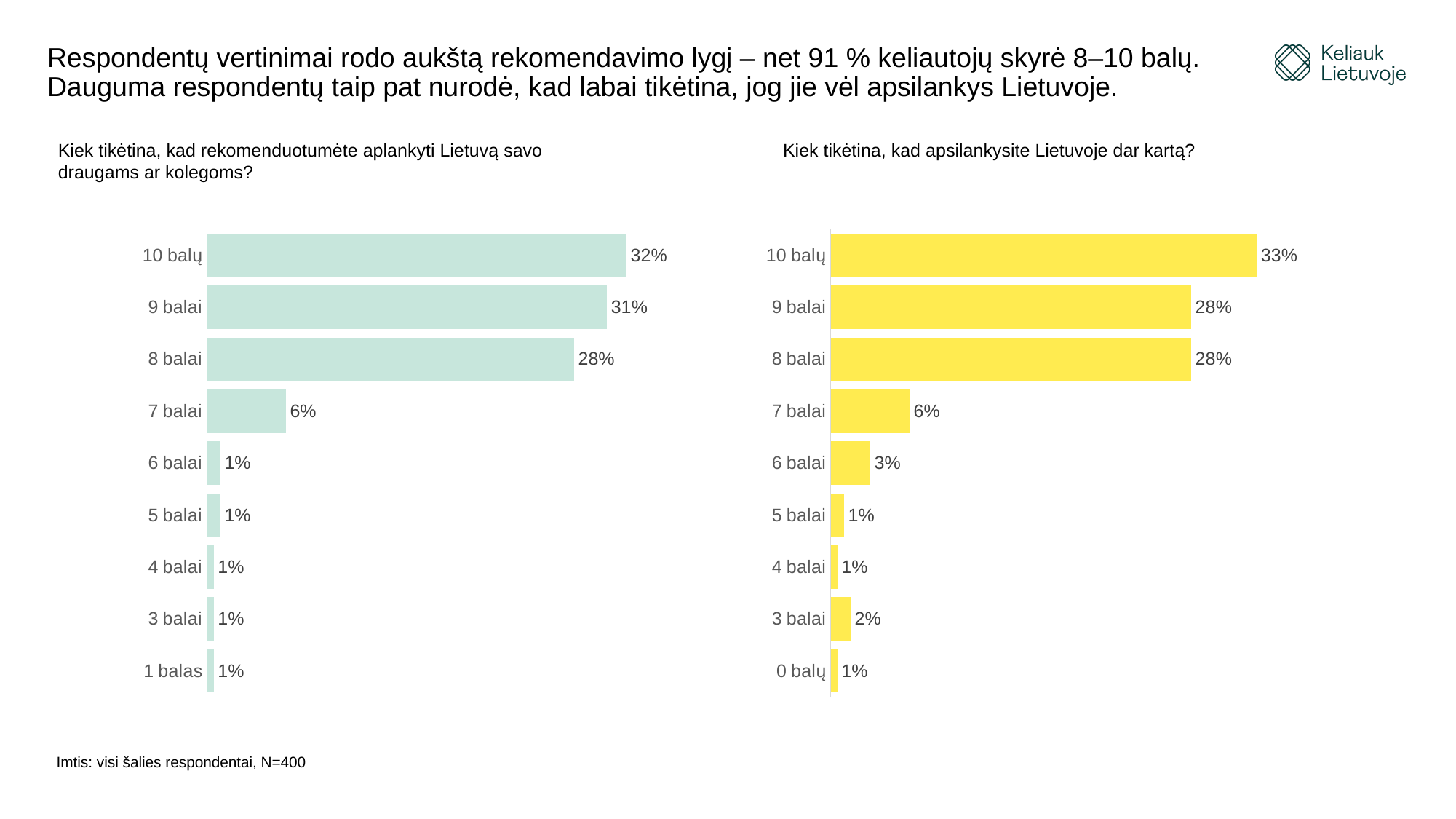
In the left chart (recommending Lithuania to friends or colleagues), what percentage of respondents gave 10 balų? 32% In the left chart (recommending Lithuania to friends or colleagues), which score category has the highest percentage? 10 balų What type of chart is used on the right (visiting Lithuania again)? Bar chart In the left chart (recommending Lithuania to friends or colleagues), what is the difference between the percentages for 10 balų and 8 balai? 4% In the right chart (visiting Lithuania again), what is the total percentage for 8 balai, 9 balai and 10 balų combined? 89% Which is larger: the percentage for 9 balai in the left chart or the percentage for 9 balai in the right chart? Left chart (31%) What colour are the bars in the right chart (visiting Lithuania again)? Yellow In the right chart (visiting Lithuania again), which score category has the highest percentage? 10 balų In the right chart (visiting Lithuania again), which is larger: the percentage for 6 balai or for 3 balai? 6 balai In the right chart (visiting Lithuania again), what percentage of respondents gave 9 balai? 28% In the right chart (visiting Lithuania again), what is the difference between the percentages for 10 balų and 7 balai? 27% How many score categories are shown in the left chart (recommending Lithuania to friends or colleagues)? 9